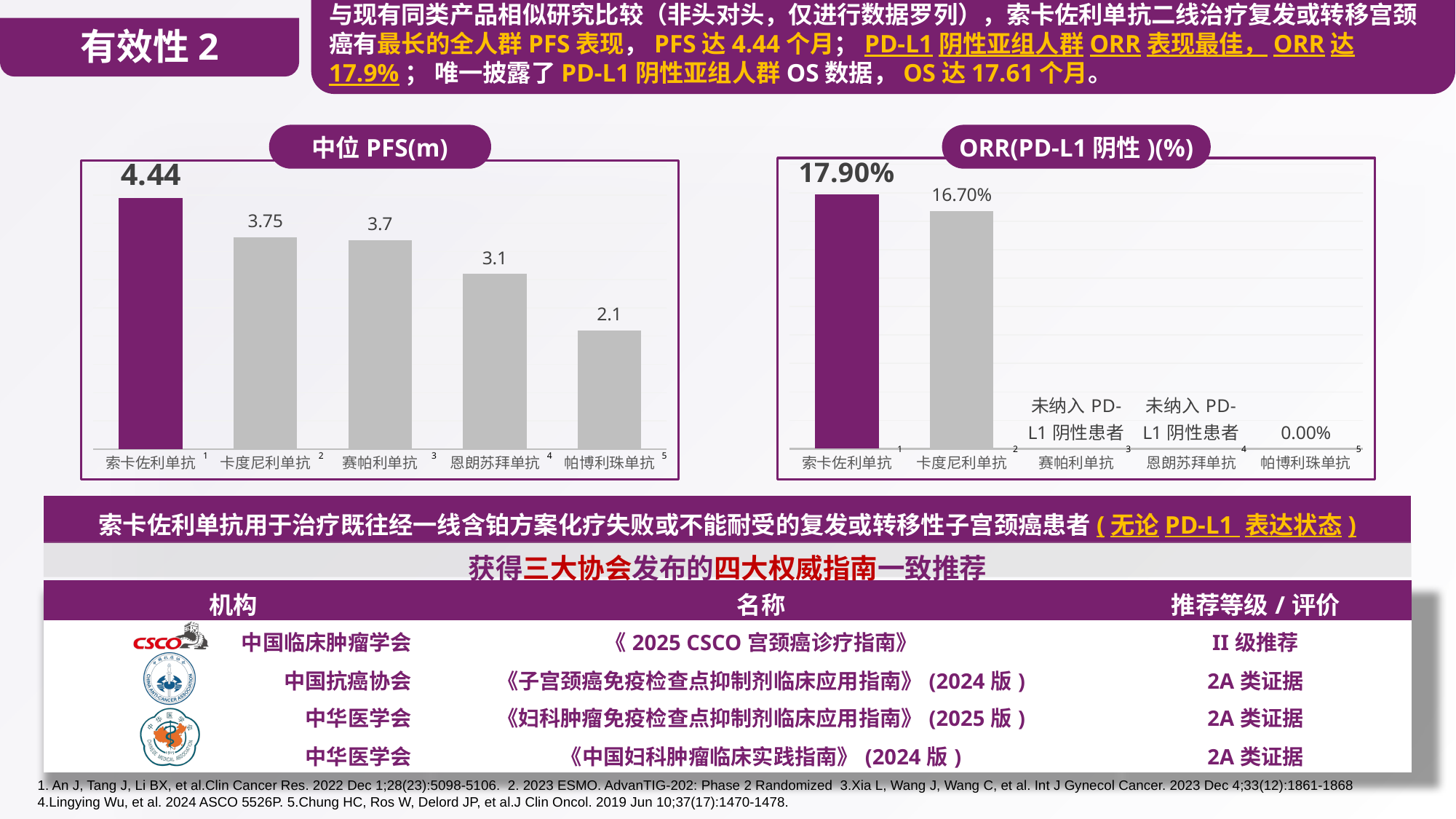
In the 中位 PFS(m) chart, what is the difference between the values for 索卡佐利单抗 and 帕博利珠单抗? 2.34 In the ORR(PD-L1 阴性)(%) chart, what is the value for 帕博利珠单抗? 0.00% What kind of chart is the ORR(PD-L1 阴性)(%) chart? bar chart In the 中位 PFS(m) chart, what is the value for 恩朗苏拜单抗? 3.1 In the ORR(PD-L1 阴性)(%) chart, what is the value for 卡度尼利单抗? 16.70% In the ORR(PD-L1 阴性)(%) chart, which is larger, the value for 索卡佐利单抗 or 卡度尼利单抗? 索卡佐利单抗 In the 中位 PFS(m) chart, how many categories are shown? 5 In the 中位 PFS(m) chart, which category has the highest value? 索卡佐利单抗 In the 中位 PFS(m) chart, do the values rise or fall from left to right? fall In the 中位 PFS(m) chart, which category has the lowest value? 帕博利珠单抗 In the ORR(PD-L1 阴性)(%) chart, what is the difference between the values for 索卡佐利单抗 and 卡度尼利单抗? 1.20% In the 中位 PFS(m) chart, what is the value for 索卡佐利单抗? 4.44